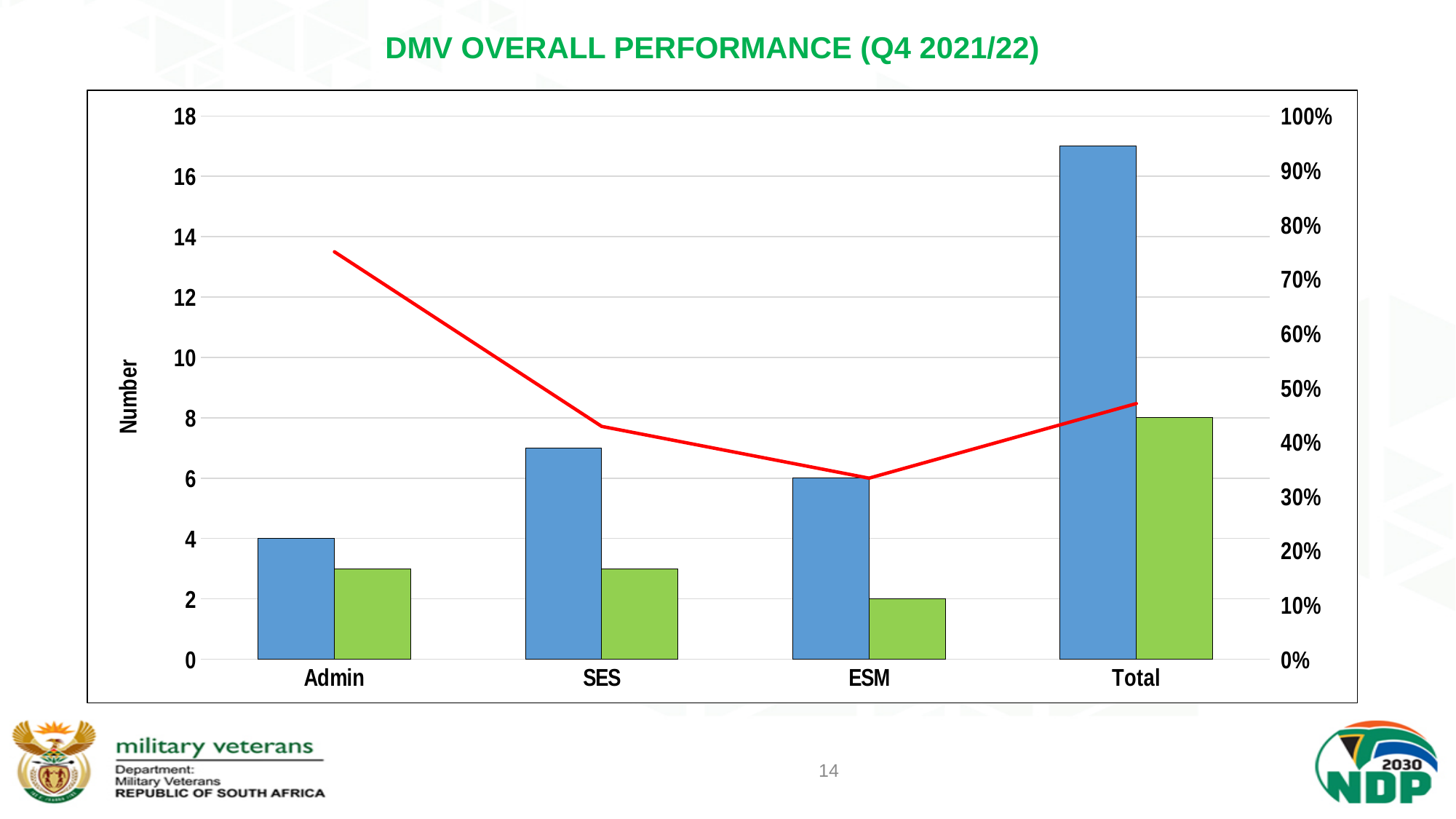
Is the value of the red line at Admin greater or less than 70%? greater What kind of chart is shown on the slide? bar chart with a line Is the value of the blue bar for Total greater or less than 16? greater What is the value of the blue bar for ESM? 6 How many categories are shown on the x axis? 4 What is the value of the green bar for ESM? 2 Which category has the tallest blue bar? Total What is the difference between the blue bar and the green bar for ESM? 4 Which category has the shortest blue bar? Admin What is the value of the green bar for Total? 8 What is the value of the blue bar for Admin? 4 What is the title of the left vertical axis? Number